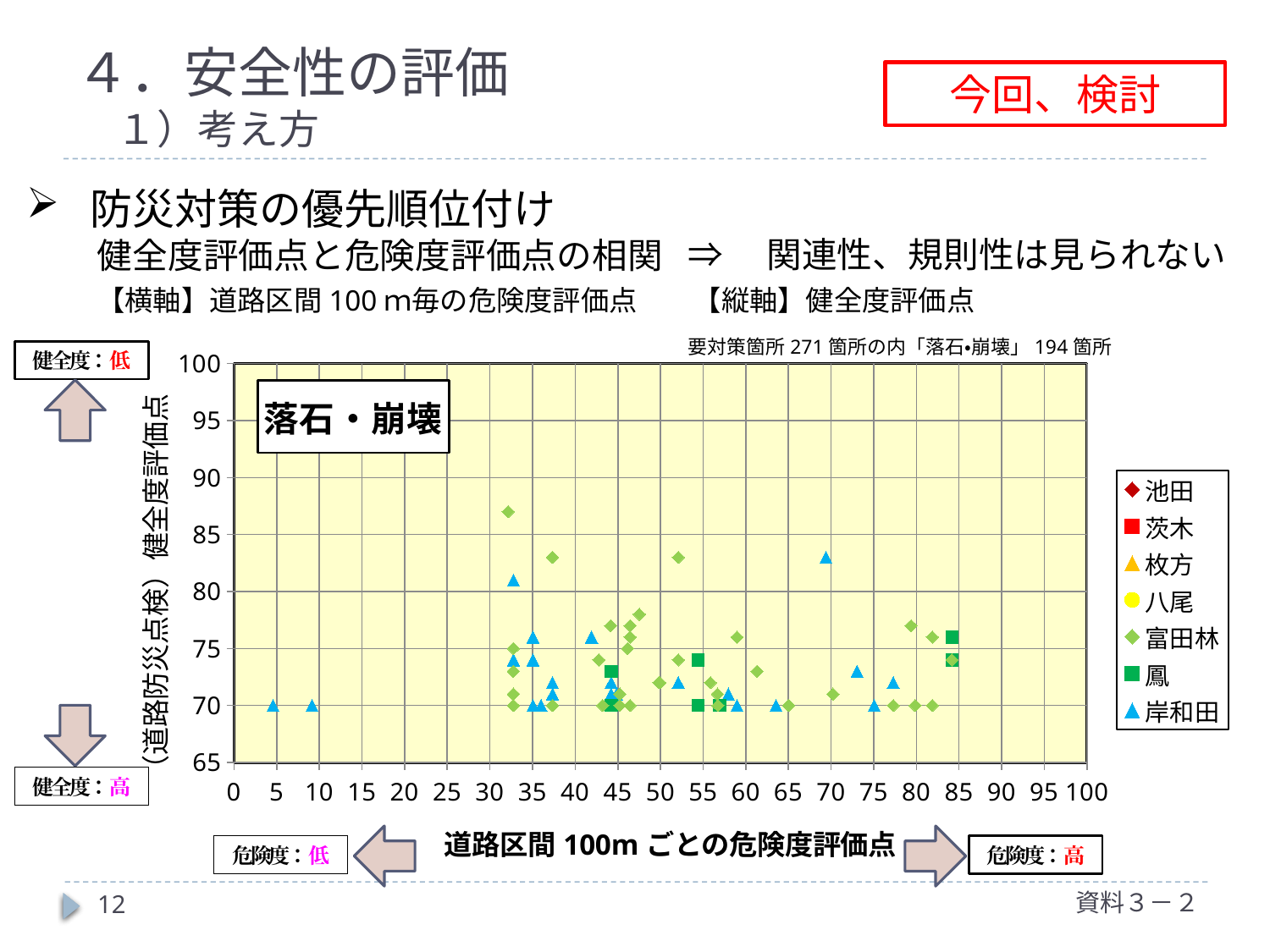
Is the x value of the leftmost point in the chart greater or less than 10? less Is the y value of the highest point in the chart greater or less than 85? greater Which series is listed last in the chart's legend? 岸和田 Which series has the most points plotted in the chart? 富田林 What is the title shown inside the plot area of the chart? 落石・崩壊 What kind of chart is shown on the slide? scatter chart Is the y value of the 岸和田 point near x = 70 greater or less than 80? greater Which series has the point with the lowest x value (危険度評価点) in the chart? 岸和田 How many series does the legend of the chart list? 7 Which series has the point with the highest 健全度評価点 (y value) in the chart? 富田林